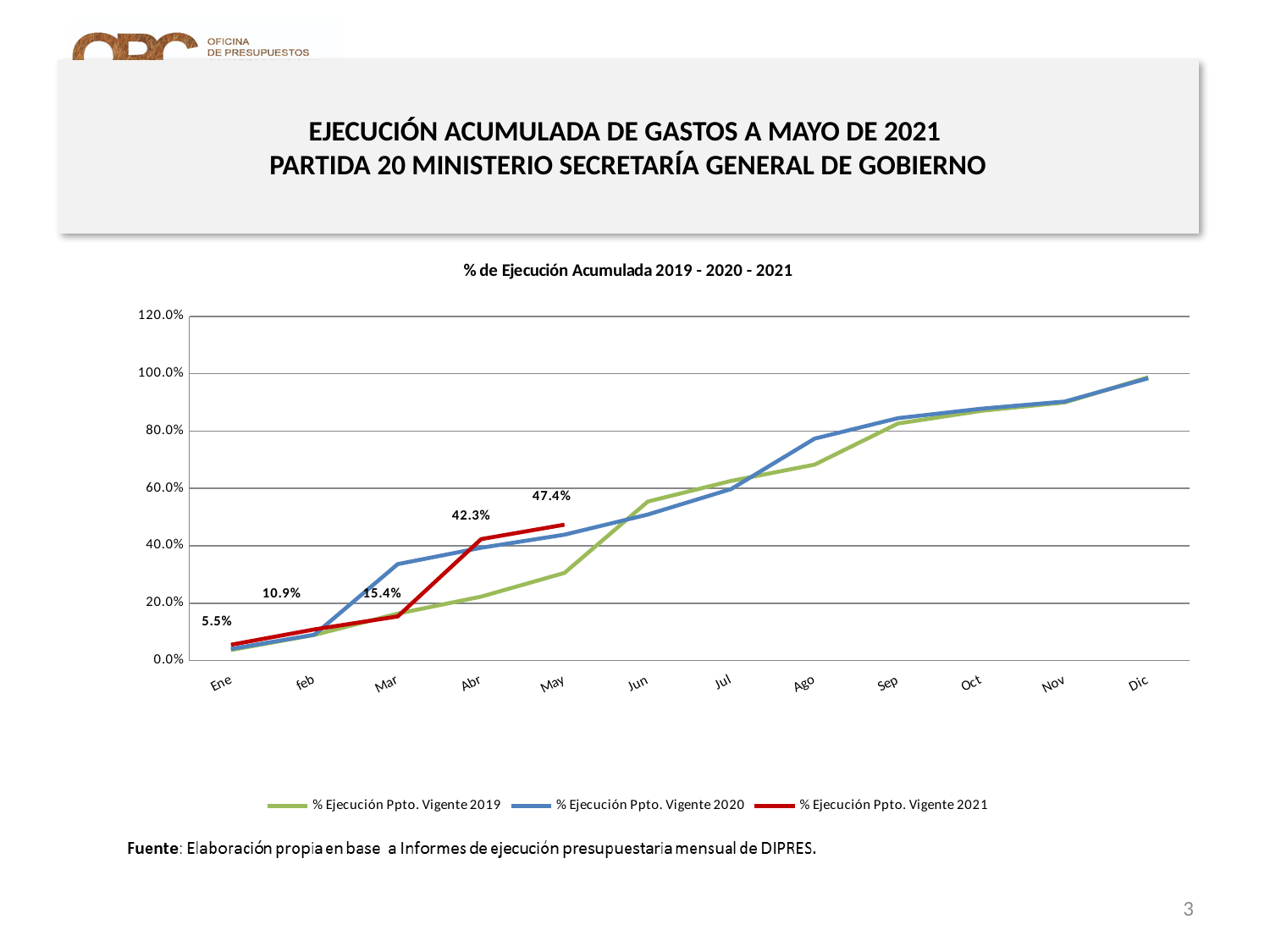
What is the title of the chart? % de Ejecución Acumulada 2019 - 2020 - 2021 Does the 2021 series rise or fall from Ene to May? Rise How many series does the legend list? 3 By how many percentage points did the 2021 series increase from Mar to Abr? 26.9 percentage points In Mar, which series is higher: % Ejecución Ppto. Vigente 2020 or % Ejecución Ppto. Vigente 2019? % Ejecución Ppto. Vigente 2020 What is the value of the % Ejecución Ppto. Vigente 2021 series in Abr? 42.3% What is the value of the % Ejecución Ppto. Vigente 2021 series in May? 47.4% How many months are shown on the x axis? 12 Is the value for the 2020 series in Dic greater or less than 80%? greater What is the difference between the 2021 values for May and Abr? 5.1 percentage points What kind of chart is shown on the slide? Line chart What is the value of the % Ejecución Ppto. Vigente 2021 series in Ene? 5.5%